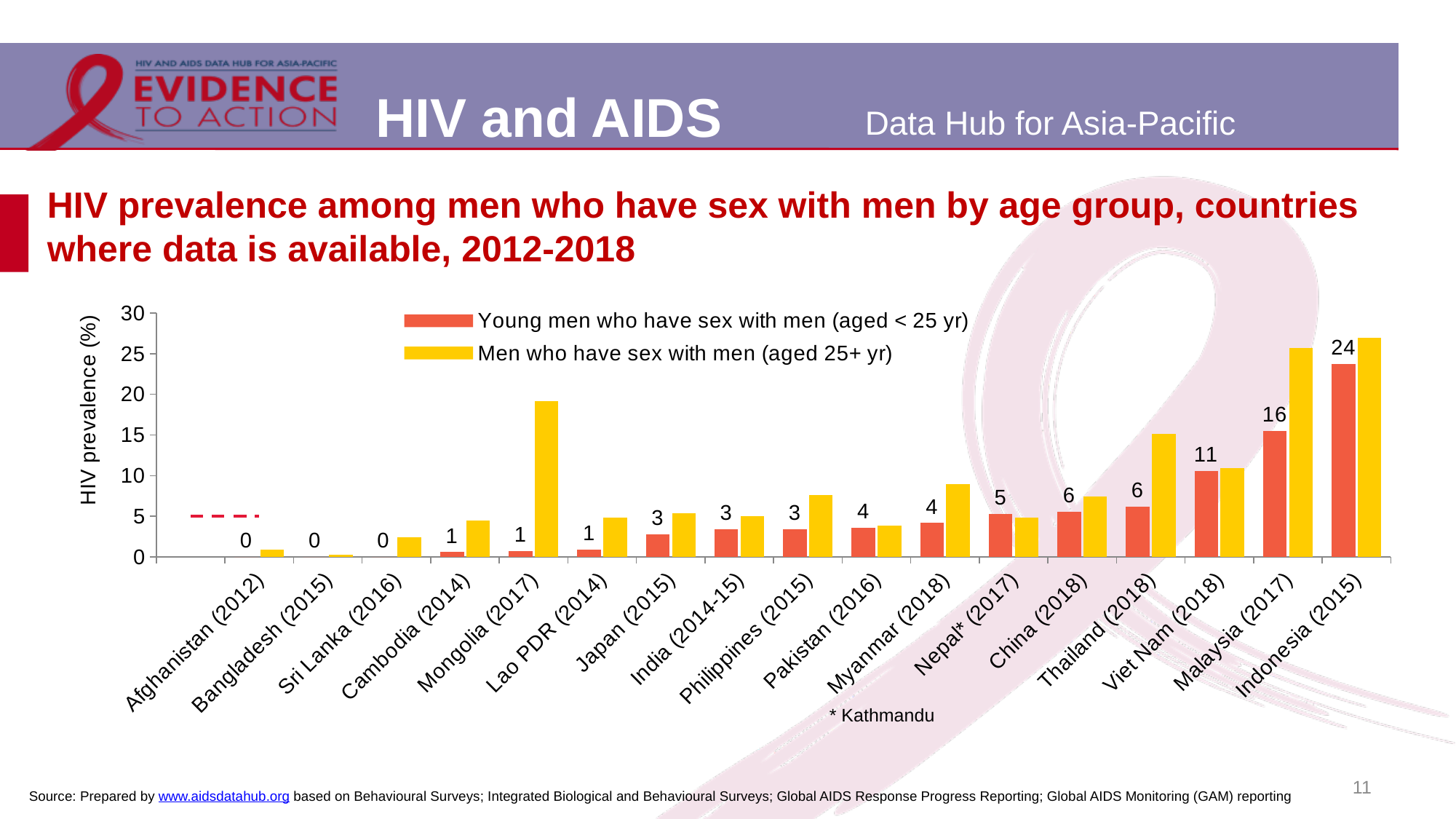
What is the difference between the HIV prevalence among young men who have sex with men (aged < 25 yr) in Indonesia (2015) and in Malaysia (2017)? 8 What is the HIV prevalence among young men who have sex with men (aged < 25 yr) in Viet Nam (2018)? 11 What type of chart is shown on the slide? Bar chart What is the HIV prevalence among young men who have sex with men (aged < 25 yr) in Nepal* (2017)? 5 What is the HIV prevalence among young men who have sex with men (aged < 25 yr) in Malaysia (2017)? 16 What is the HIV prevalence among young men who have sex with men (aged < 25 yr) in Indonesia (2015)? 24 Is the HIV prevalence among men who have sex with men (aged 25+ yr) in Myanmar (2018) greater or less than 10? less Which has a higher HIV prevalence among young men who have sex with men (aged < 25 yr): Viet Nam (2018) or Thailand (2018)? Viet Nam (2018) Is the HIV prevalence among men who have sex with men (aged 25+ yr) in Mongolia (2017) greater or less than 15? greater Which country has the highest HIV prevalence among young men who have sex with men (aged < 25 yr)? Indonesia (2015) How many countries are shown on the x axis of the chart? 17 How many series does the chart legend list? 2